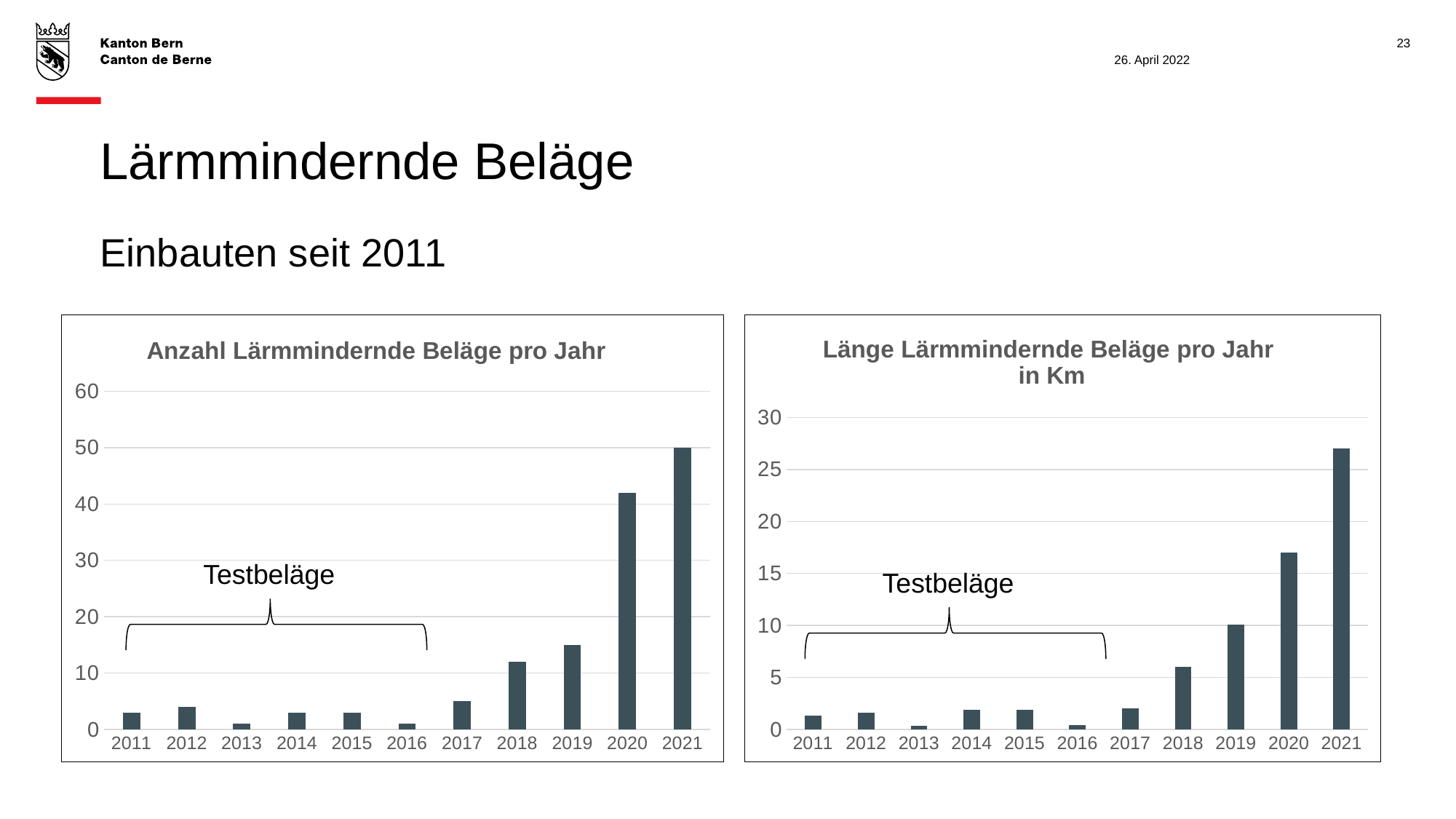
What label is written above the bracket covering the years 2011 to 2016 in both charts? Testbeläge In the left chart 'Anzahl Lärmmindernde Beläge pro Jahr', which year has the highest value? 2021 In the left chart 'Anzahl Lärmmindernde Beläge pro Jahr', what is the value for 2021? 50 In the left chart 'Anzahl Lärmmindernde Beläge pro Jahr', is the value for 2019 greater or less than 20? less In the right chart 'Länge Lärmmindernde Beläge pro Jahr in Km', do the values generally rise or fall from 2017 to 2021? Rise In the right chart 'Länge Lärmmindernde Beläge pro Jahr in Km', is the value for 2021 greater or less than 25? greater In the left chart 'Anzahl Lärmmindernde Beläge pro Jahr', how many years are shown on the x axis? 11 What kind of chart is the left chart, 'Anzahl Lärmmindernde Beläge pro Jahr'? Bar chart In the left chart 'Anzahl Lärmmindernde Beläge pro Jahr', is the value for 2020 greater or less than 40? greater In the left chart 'Anzahl Lärmmindernde Beläge pro Jahr', which year has the larger value, 2019 or 2020? 2020 In the right chart 'Länge Lärmmindernde Beläge pro Jahr in Km', which year has the highest value? 2021